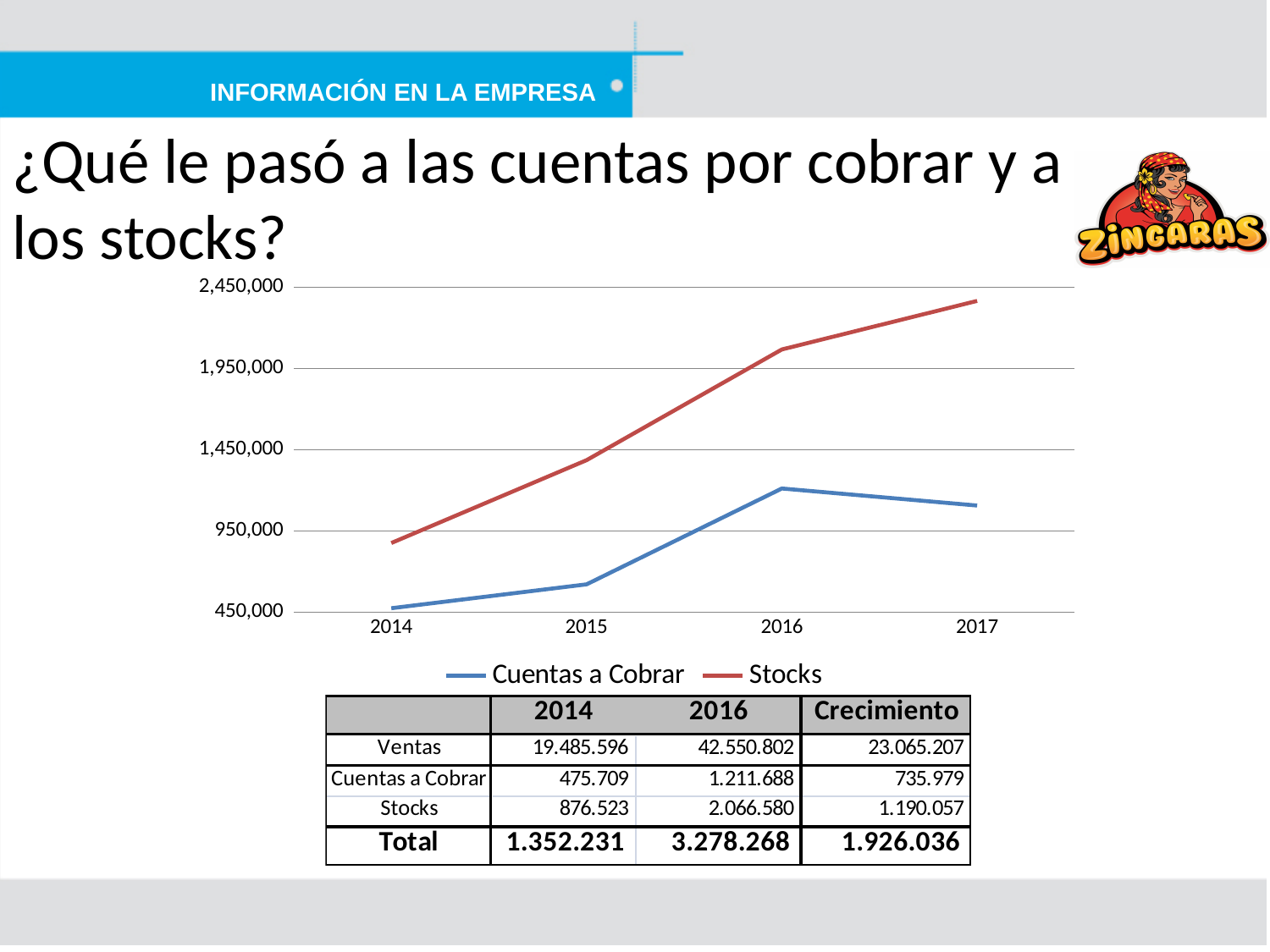
Is the value for Stocks in 2017 greater or less than 1,950,000? greater In which year does the Stocks line reach its highest value? 2017 Does the Stocks line rise or fall from 2014 to 2017? rise Is the value for Cuentas a Cobrar in 2016 greater or less than 950,000? greater Which series is drawn in red in the chart? Stocks Is the value for Stocks in 2014 greater or less than 950,000? less How many years are plotted along the x axis of the chart? 4 In which year does the Cuentas a Cobrar line reach its highest value? 2016 How many series does the chart legend list? 2 In 2016, which series has the larger value, Stocks or Cuentas a Cobrar? Stocks What kind of chart is shown on the slide? line chart